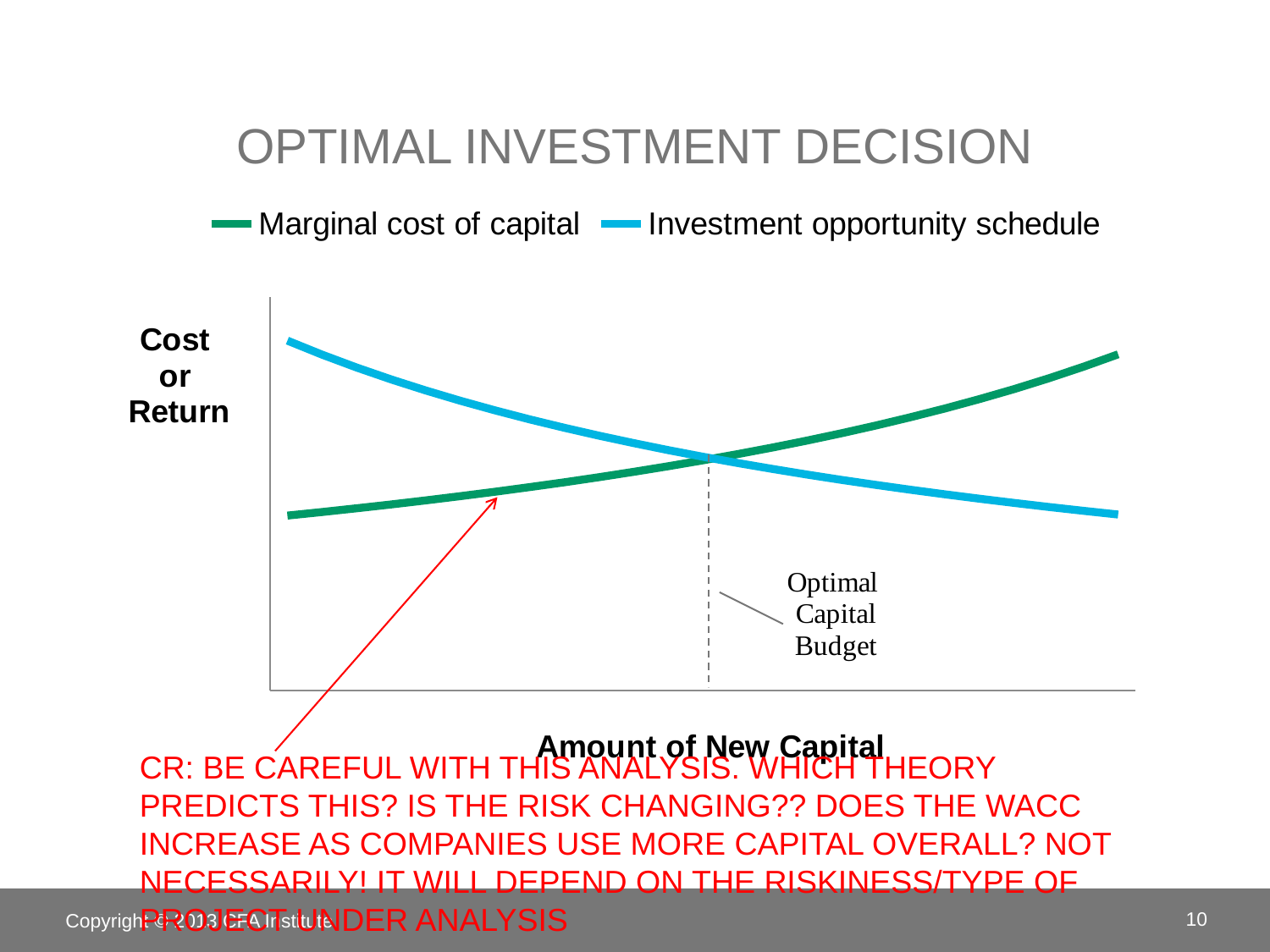
How many series does the legend list? 2 Which series is drawn in light blue? Investment opportunity schedule Does the Investment opportunity schedule line rise or fall as the amount of new capital increases? Falls At the left edge of the chart, which line is higher: Marginal cost of capital or Investment opportunity schedule? Investment opportunity schedule Does the Marginal cost of capital line rise or fall as the amount of new capital increases? Rises At the right edge of the chart, which line is higher: Marginal cost of capital or Investment opportunity schedule? Marginal cost of capital What is the title of the chart? OPTIMAL INVESTMENT DECISION What kind of chart is shown on the slide? Line chart What label is given to the point where the two lines intersect? Optimal Capital Budget